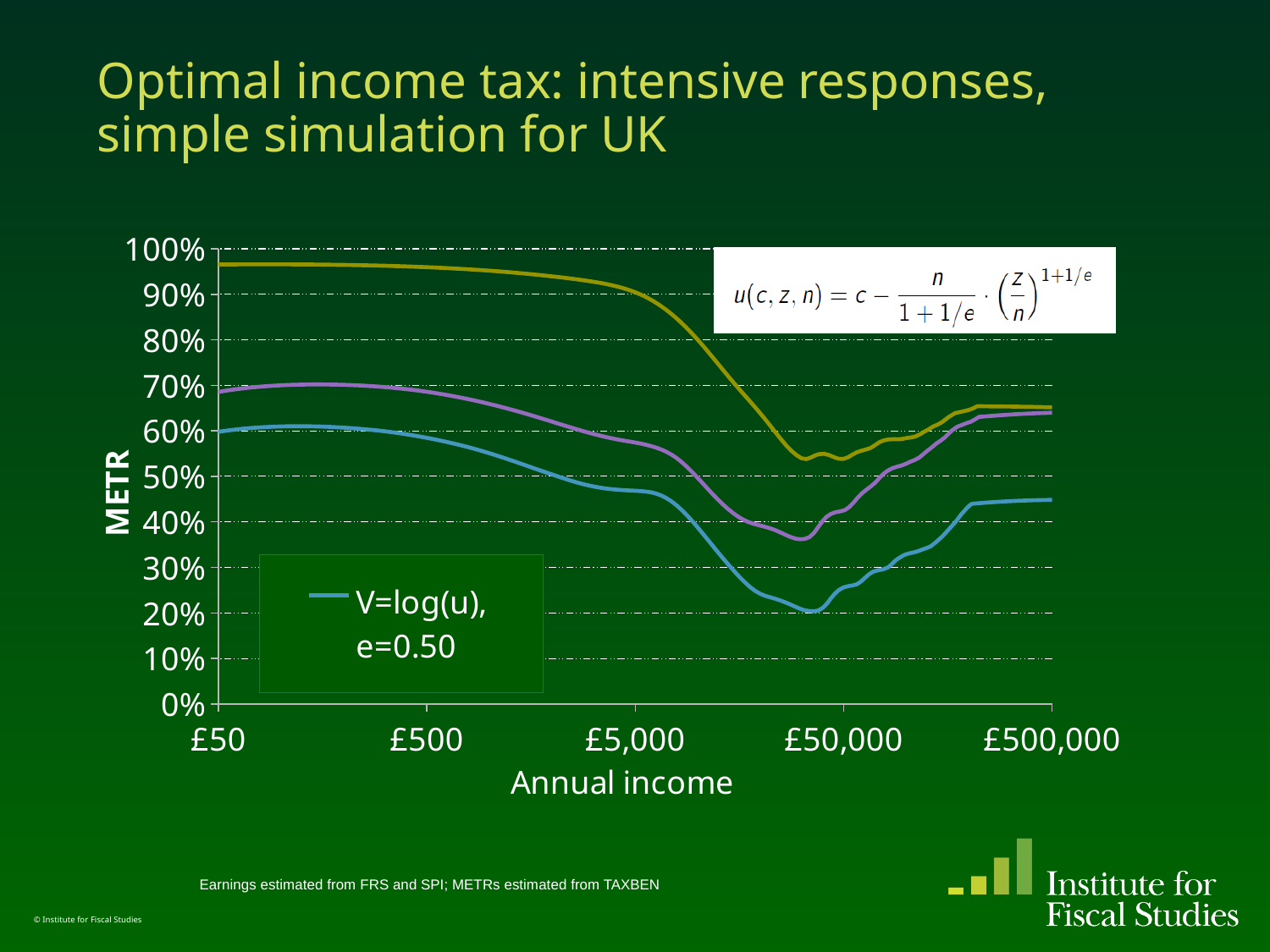
Is the value of the V=log(u), e=0.50 line at £50,000 greater or less than 30%? less Does the V=log(u), e=0.50 line rise or fall between £500 and £50,000? fall Is the value of the V=log(u), e=0.50 line at £500,000 greater or less than 50%? less Is the value of the V=log(u), e=0.50 line at £5,000 greater or less than 50%? less What kind of chart is shown on the slide? line chart What is the label of the vertical axis? METR How many series does the chart's legend list? 1 Of the three lines plotted, is the V=log(u), e=0.50 line the highest or the lowest at £50,000? lowest What is the label of the series listed in the legend? V=log(u), e=0.50 Does the V=log(u), e=0.50 line rise or fall between £50,000 and £500,000? rise How many lines are plotted on the chart? 3